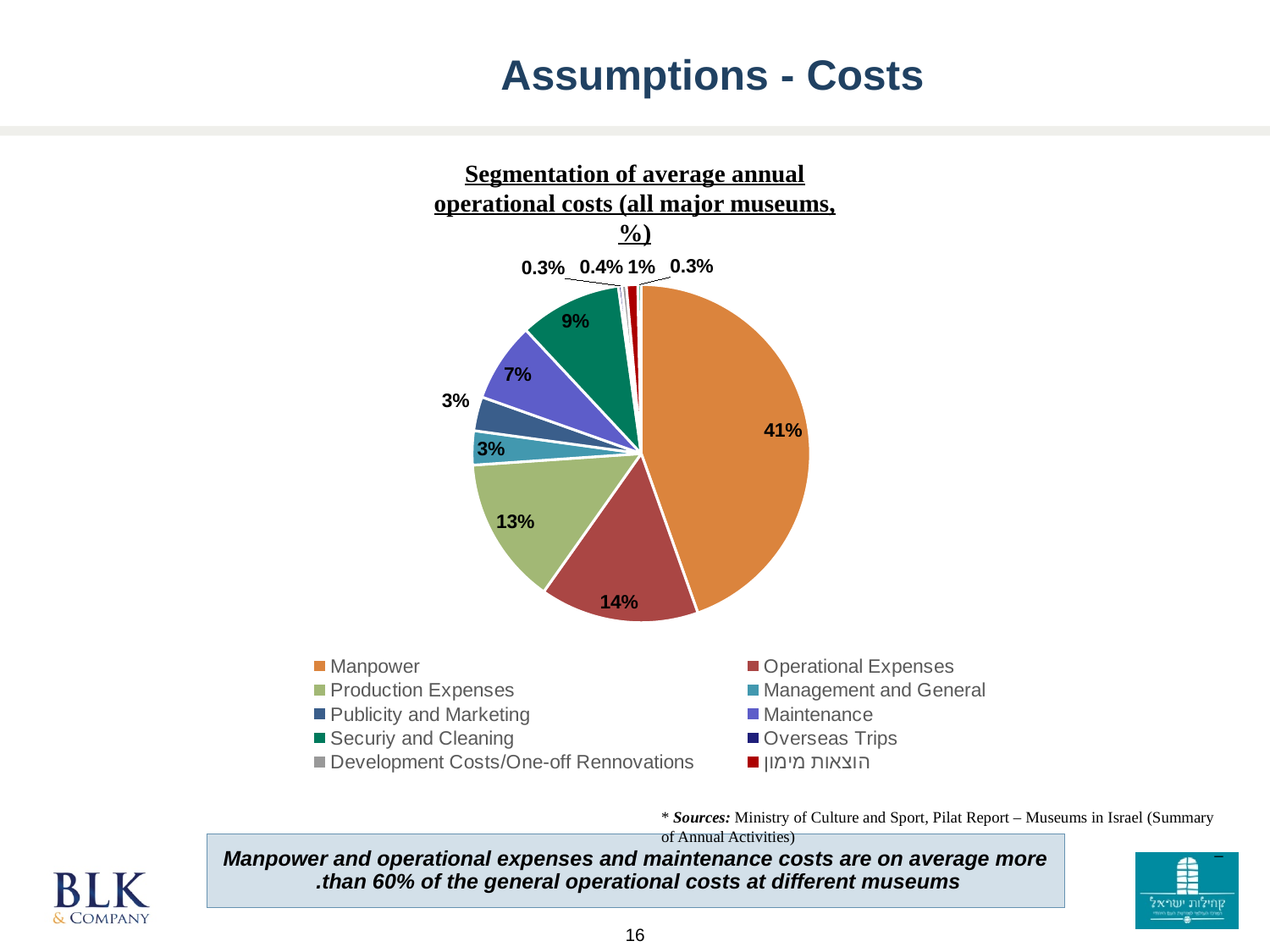
How many entries does the chart legend list? 10 What share of average annual operational costs is Production Expenses? 13% What share of average annual operational costs is Securiy and Cleaning? 9% What colour is the Manpower slice of the pie chart? orange What share of average annual operational costs is Maintenance? 7% What is the difference in percentage points between the Manpower share and the Operational Expenses share? 27 What kind of chart is shown on the slide? pie chart What share of average annual operational costs is Operational Expenses? 14% Which has a larger share, Production Expenses or Maintenance? Production Expenses Which has a larger share, Securiy and Cleaning or Operational Expenses? Operational Expenses What share of average annual operational costs is Manpower? 41% Which category has the largest share of average annual operational costs? Manpower